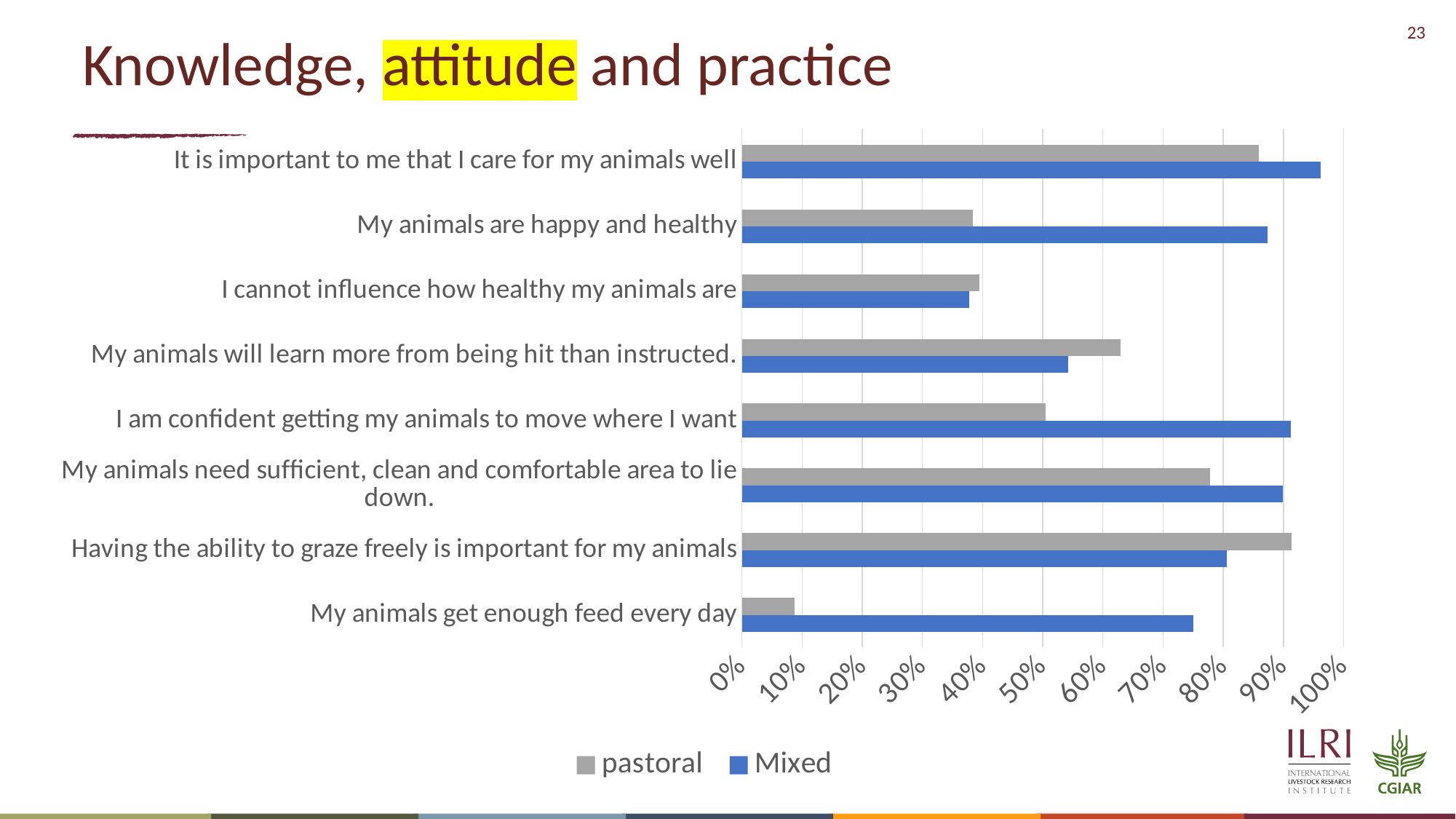
Is the pastoral value for 'My animals are happy and healthy' greater or less than 50%? less Is the Mixed value for 'My animals are happy and healthy' greater or less than 80%? greater How many statements (categories) are plotted on the chart? 8 For 'Having the ability to graze freely is important for my animals', which series has the larger value, pastoral or Mixed? pastoral Is the pastoral value for 'My animals get enough feed every day' greater or less than 20%? less What kind of chart is shown on the slide? bar chart How many series does the legend list? 2 Which two series are shown in the legend? pastoral and Mixed Which statement has the highest Mixed value? It is important to me that I care for my animals well Which statement has the lowest pastoral value? My animals get enough feed every day For 'My animals get enough feed every day', which series has the larger value, pastoral or Mixed? Mixed Which statement has the lowest Mixed value? I cannot influence how healthy my animals are